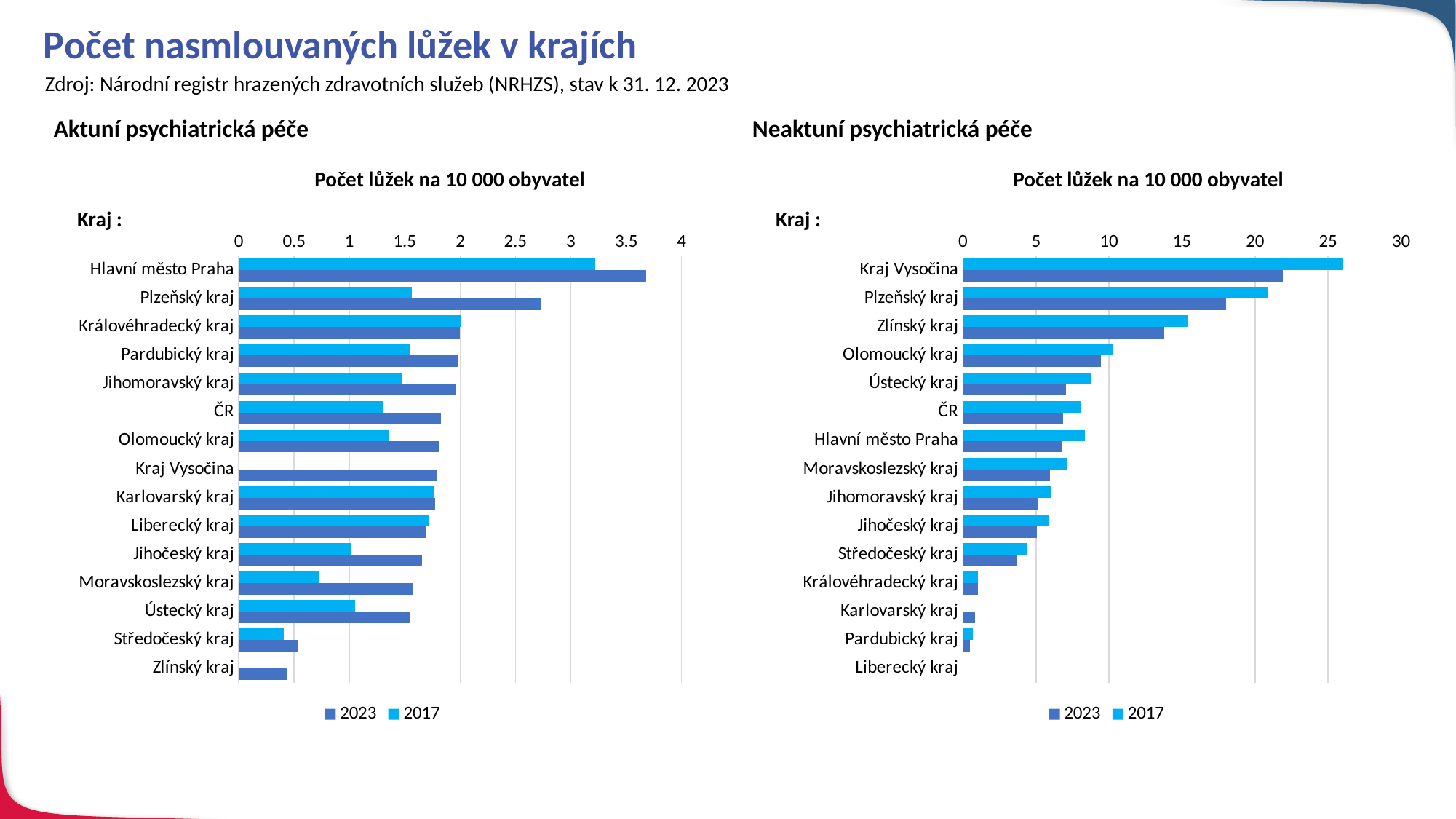
In the 'Aktuní psychiatrická péče' chart on the left, which region has the lowest 2023 value? Zlínský kraj In the 'Neaktuní psychiatrická péče' chart on the right, which is larger for Hlavní město Praha, the 2023 value or the 2017 value? 2017 In the 'Aktuní psychiatrická péče' chart on the left, which is larger for Moravskoslezský kraj, the 2023 value or the 2017 value? 2023 How many series does the legend of the 'Neaktuní psychiatrická péče' chart on the right list? 2 In the 'Aktuní psychiatrická péče' chart on the left, is the 2023 value for Plzeňský kraj greater or less than 2.5? greater In the 'Neaktuní psychiatrická péče' chart on the right, is the 2017 value for Kraj Vysočina greater or less than 25? greater What kind of chart is the 'Aktuní psychiatrická péče' chart on the left? bar chart In the 'Neaktuní psychiatrická péče' chart on the right, is the 2023 value for Zlínský kraj greater or less than 15? less In the 'Aktuní psychiatrická péče' chart on the left, which region has the highest 2023 value? Hlavní město Praha How many regions (kraje) are listed on the 'Aktuní psychiatrická péče' chart on the left? 15 In the 'Neaktuní psychiatrická péče' chart on the right, which region has the highest 2017 value? Kraj Vysočina